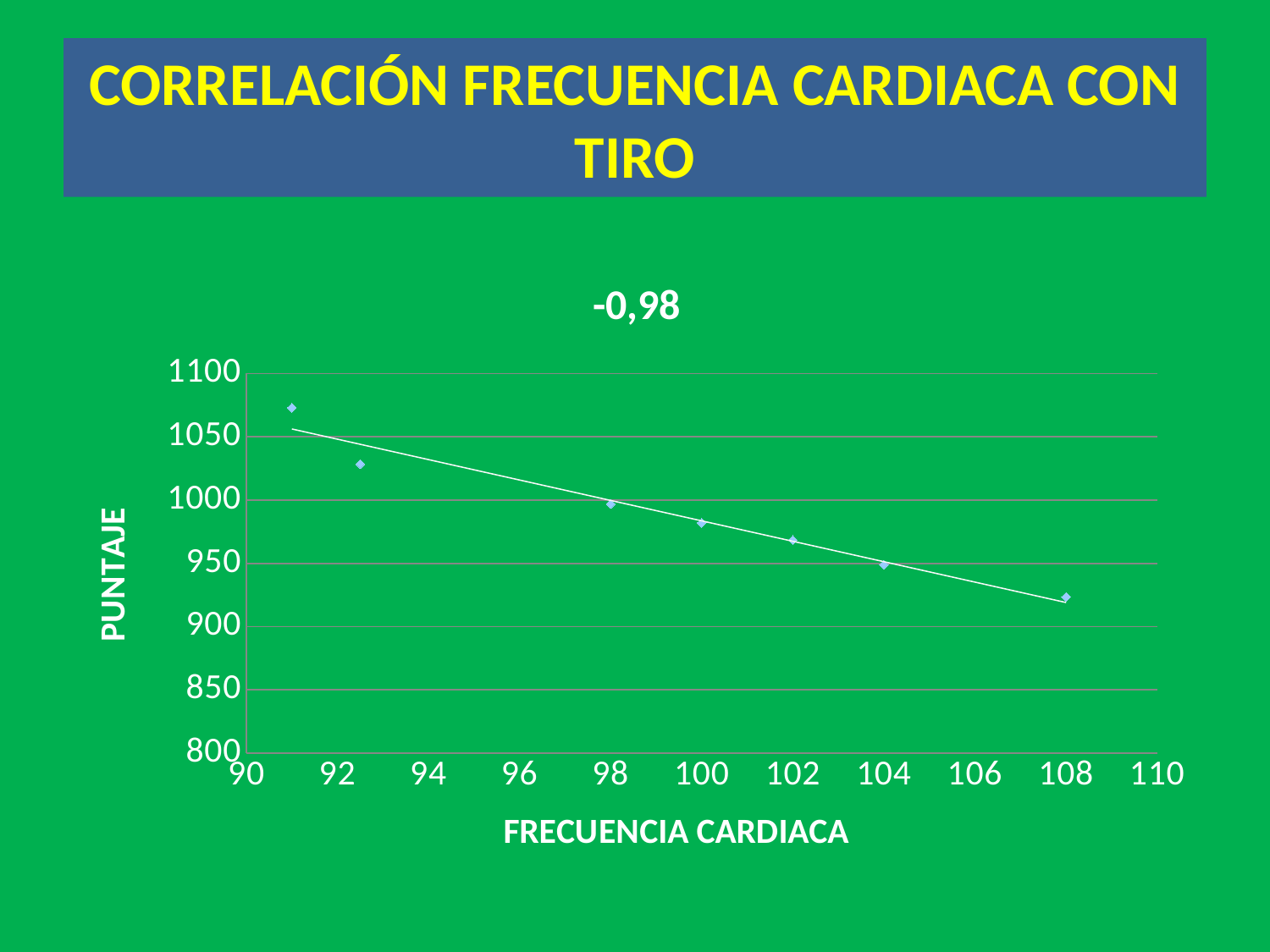
What is the label of the vertical axis? PUNTAJE How many data points are plotted on the chart? 7 Is the PUNTAJE value for the point at FRECUENCIA CARDIACA 108 greater or less than 950? less Is the highest PUNTAJE value found at the left end or the right end of the x axis? left end Is the lowest PUNTAJE value found at the left end or the right end of the x axis? right end Do the PUNTAJE values rise or fall as FRECUENCIA CARDIACA increases along the x axis? fall What is the title shown above the chart? -0,98 Is the PUNTAJE value for the point at FRECUENCIA CARDIACA 102 greater or less than 950? greater Is the PUNTAJE value for the point at FRECUENCIA CARDIACA 100 greater or less than 1000? less What kind of chart is shown on the slide? scatter chart Which has the higher PUNTAJE value, the point at FRECUENCIA CARDIACA 100 or the point at FRECUENCIA CARDIACA 108? the point at 100